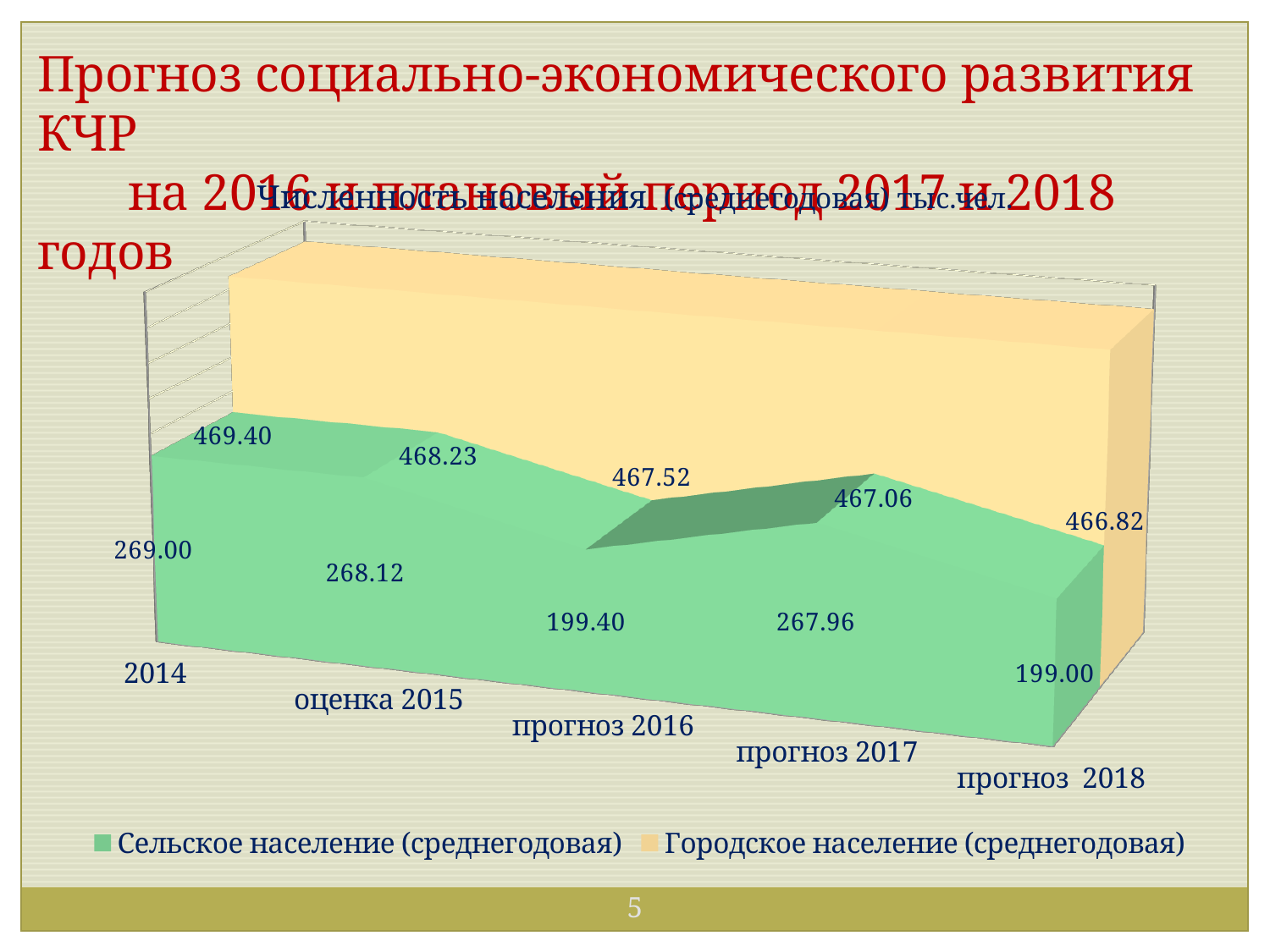
What kind of chart is shown on the slide? area chart What is the value for Сельское население (среднегодовая) in прогноз 2016? 199.40 What is the difference between the Городское население (среднегодовая) values for 2014 and прогноз 2018? 2.58 How many periods are shown on the x axis? 5 What is the value for Городское население (среднегодовая) in оценка 2015? 468.23 What is the value for Городское население (среднегодовая) in прогноз 2018? 466.82 Do the values for Городское население (среднегодовая) rise or fall from 2014 to прогноз 2018? fall What is the value for Сельское население (среднегодовая) in 2014? 269.00 Which is larger for Сельское население (среднегодовая): the value for 2014 or for прогноз 2017? 2014 In which period is Сельское население (среднегодовая) lowest? прогноз 2018 How many series does the legend list? 2 In which period is Городское население (среднегодовая) highest? 2014